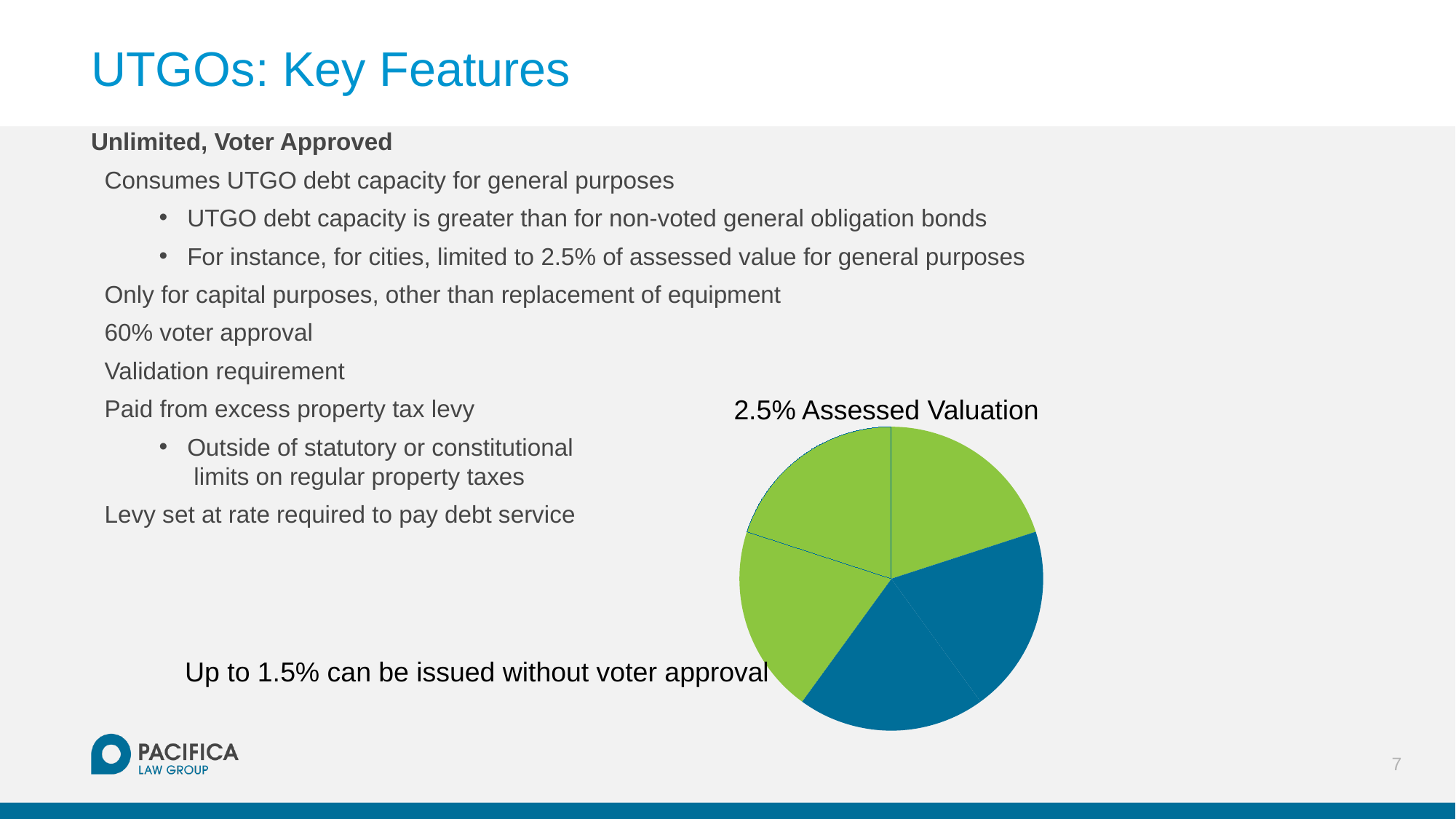
How many different colours are used for the slices of the pie chart? 2 What kind of chart is shown on the slide? pie chart Is the green portion of the pie chart greater or less than half of the pie? greater Which colour covers the larger portion of the pie chart, green or blue? green What is the title of the pie chart? 2.5% Assessed Valuation Does the pie chart have a legend? No Is the blue portion of the pie chart greater or less than half of the pie? less